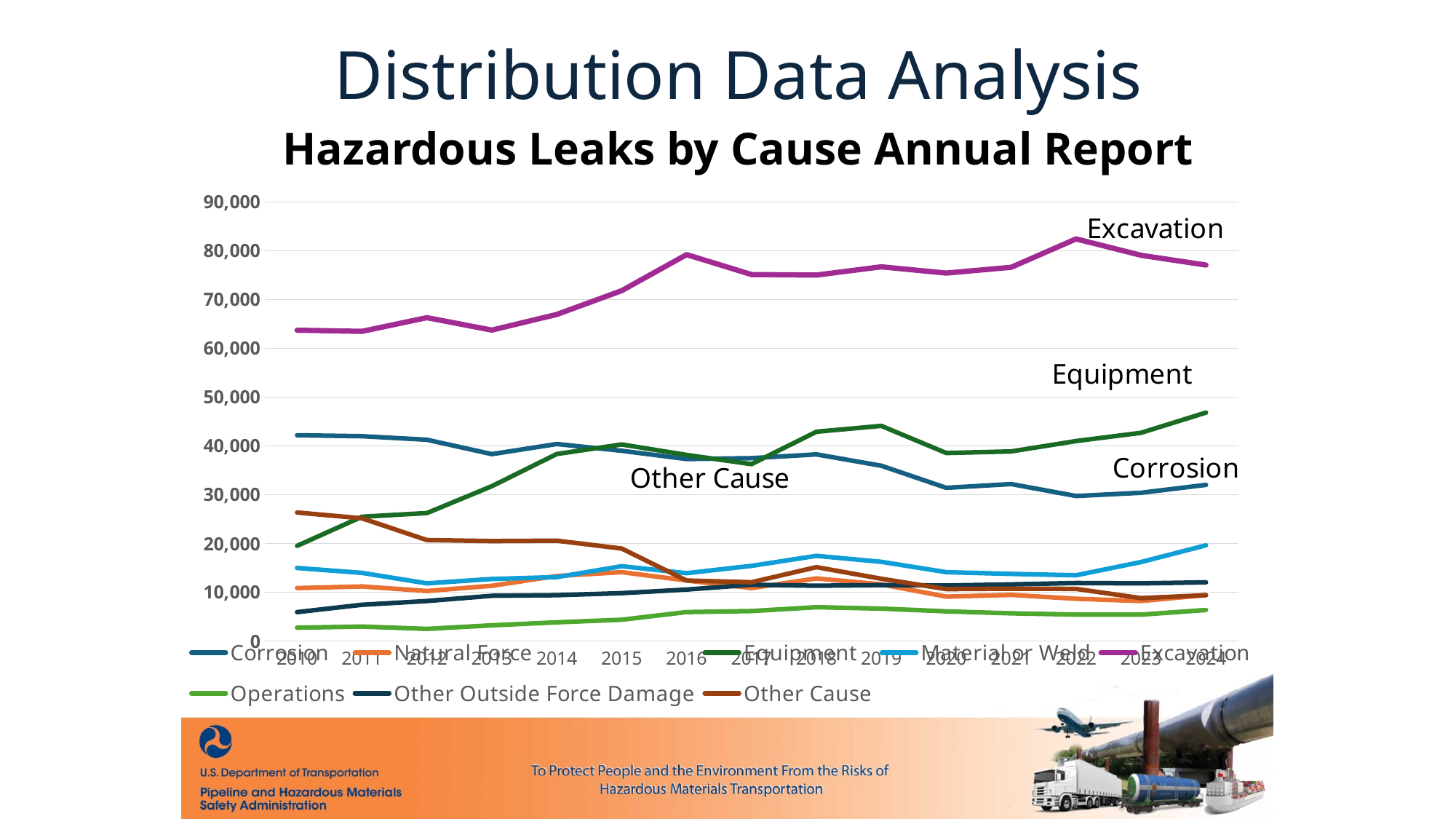
Is the value for Excavation in 2022 greater or less than 80,000? greater Which cause has the lowest number of hazardous leaks in 2024? Operations In 2010, which is larger: Corrosion or Equipment? Corrosion Is the value for Other Cause in 2010 greater or less than 20,000? greater What is the title of the chart? Hazardous Leaks by Cause Annual Report How many series does the legend list? 8 What kind of chart is shown on the slide? Line chart How many years are plotted along the x axis? 15 Which cause has the highest number of hazardous leaks in 2024? Excavation Is the value for Equipment in 2024 greater or less than 50,000? less Does the Corrosion line generally rise or fall from 2010 to 2024? Fall